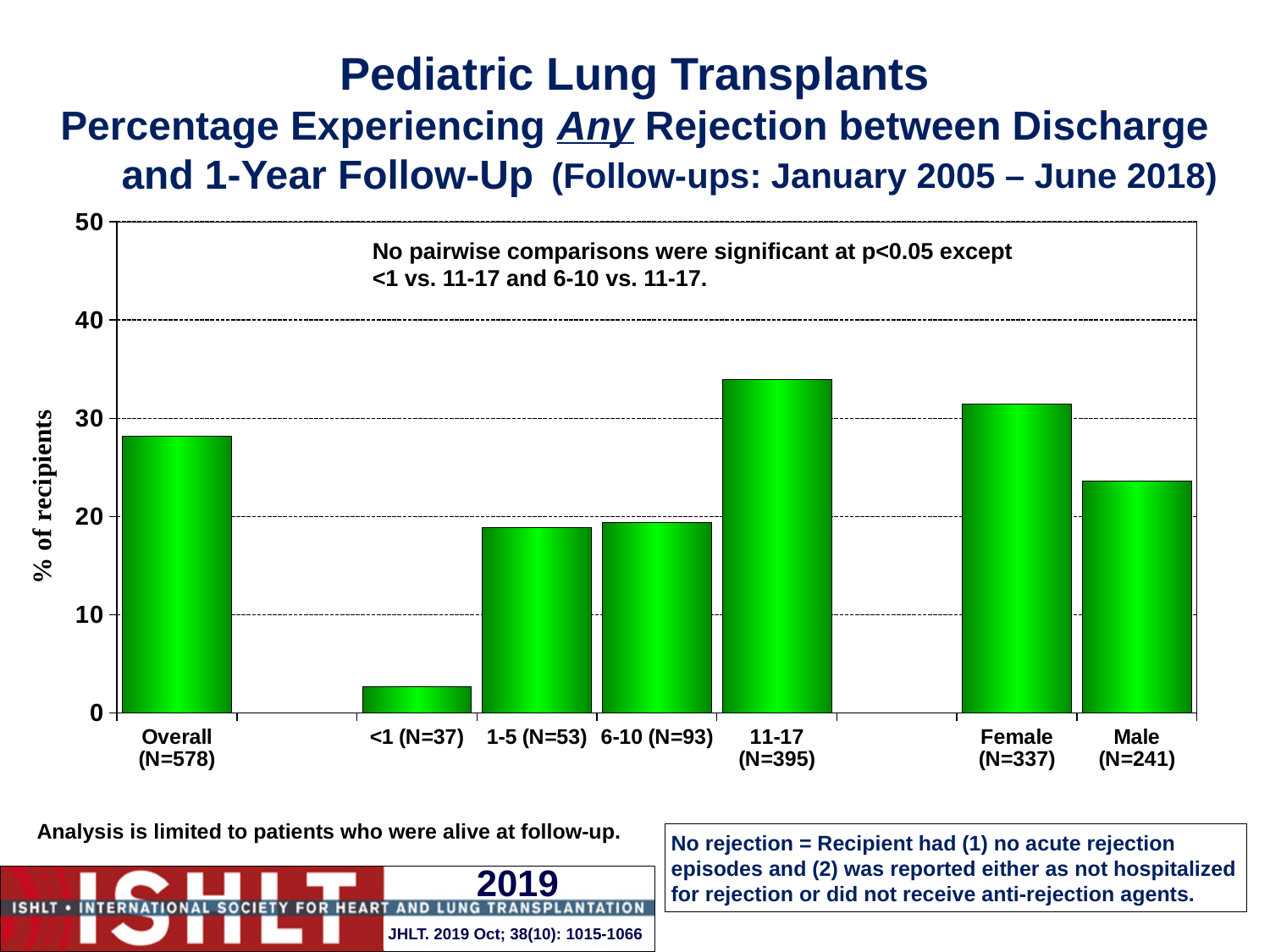
Which category has the highest percentage of recipients experiencing any rejection? 11-17 (N=395) How many categories (bars) are plotted in the chart? 7 Is the value for <1 (N=37) greater or less than 10? less Is the value for Male (N=241) greater or less than 30? less What kind of chart is shown on the slide? bar chart Which has the larger percentage of recipients experiencing any rejection, Female or Male? Female Which has the larger percentage of recipients experiencing any rejection, Overall or Male? Overall Is the value for 6-10 (N=93) greater or less than 10? greater Which category has the lowest percentage of recipients experiencing any rejection? <1 (N=37) What is the label of the y-axis of the chart? % of recipients